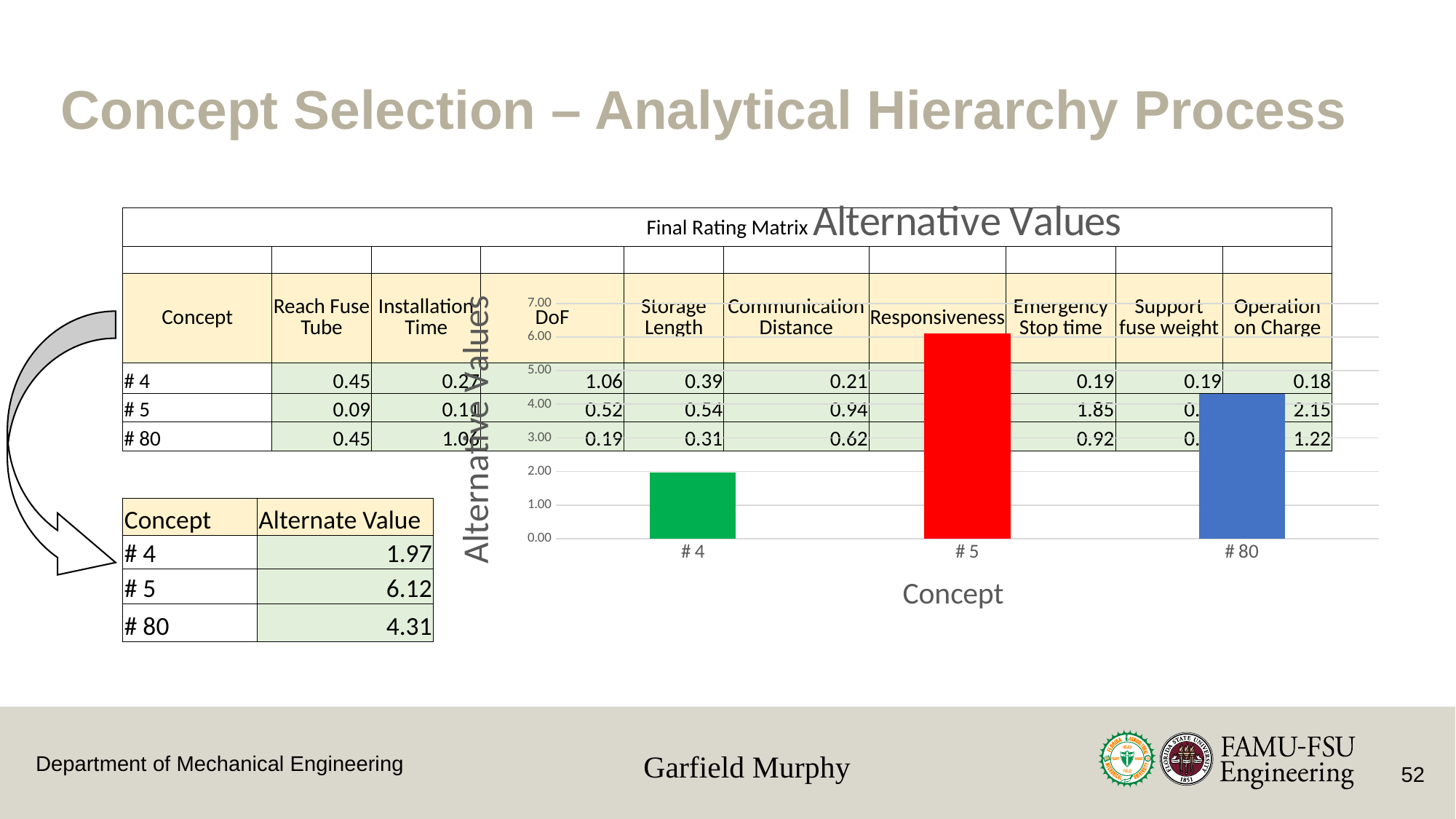
Which has the larger value in the chart, # 80 or # 4? # 80 Is the value for # 5 greater or less than 5.00? greater Which concept has the highest bar in the chart? # 5 Which has the larger value in the chart, # 5 or # 80? # 5 What kind of chart is shown on the slide? bar chart Is the value for # 80 greater or less than 5.00? less Is the value for # 80 greater or less than 3.00? greater What is the label on the x axis of the chart? Concept What is the title of the chart? Alternative Values Which concept has the lowest bar in the chart? # 4 How many concepts are plotted in the bar chart? 3